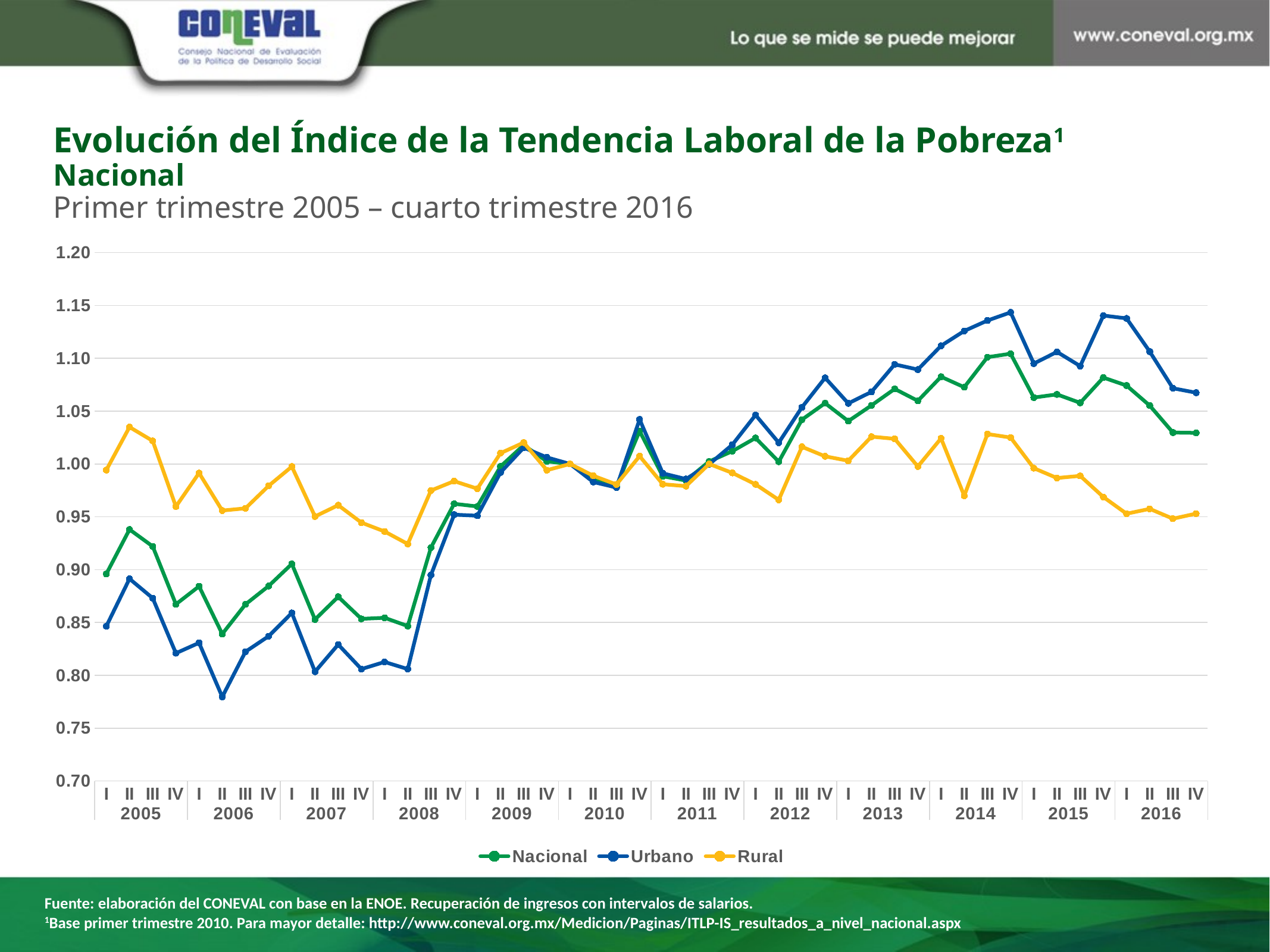
Is the value for Urbano in quarter II of 2006 greater or less than 0.80? less In quarter IV of 2016, which is higher, Urbano or Rural? Urbano Which series are listed in the legend? Nacional, Urbano, Rural Is the value for Urbano in quarter IV of 2014 greater or less than 1.10? greater Which series has the lowest value in quarter II of 2006? Urbano How many series does the legend list? 3 How many years are labelled along the x axis? 12 Does the Urbano series overall rise or fall from 2005 to 2016? rise Is the value for Rural in quarter IV of 2016 greater or less than 1.00? less What kind of chart is shown on the slide? line chart In quarter I of 2005, which is higher, Rural or Urbano? Rural